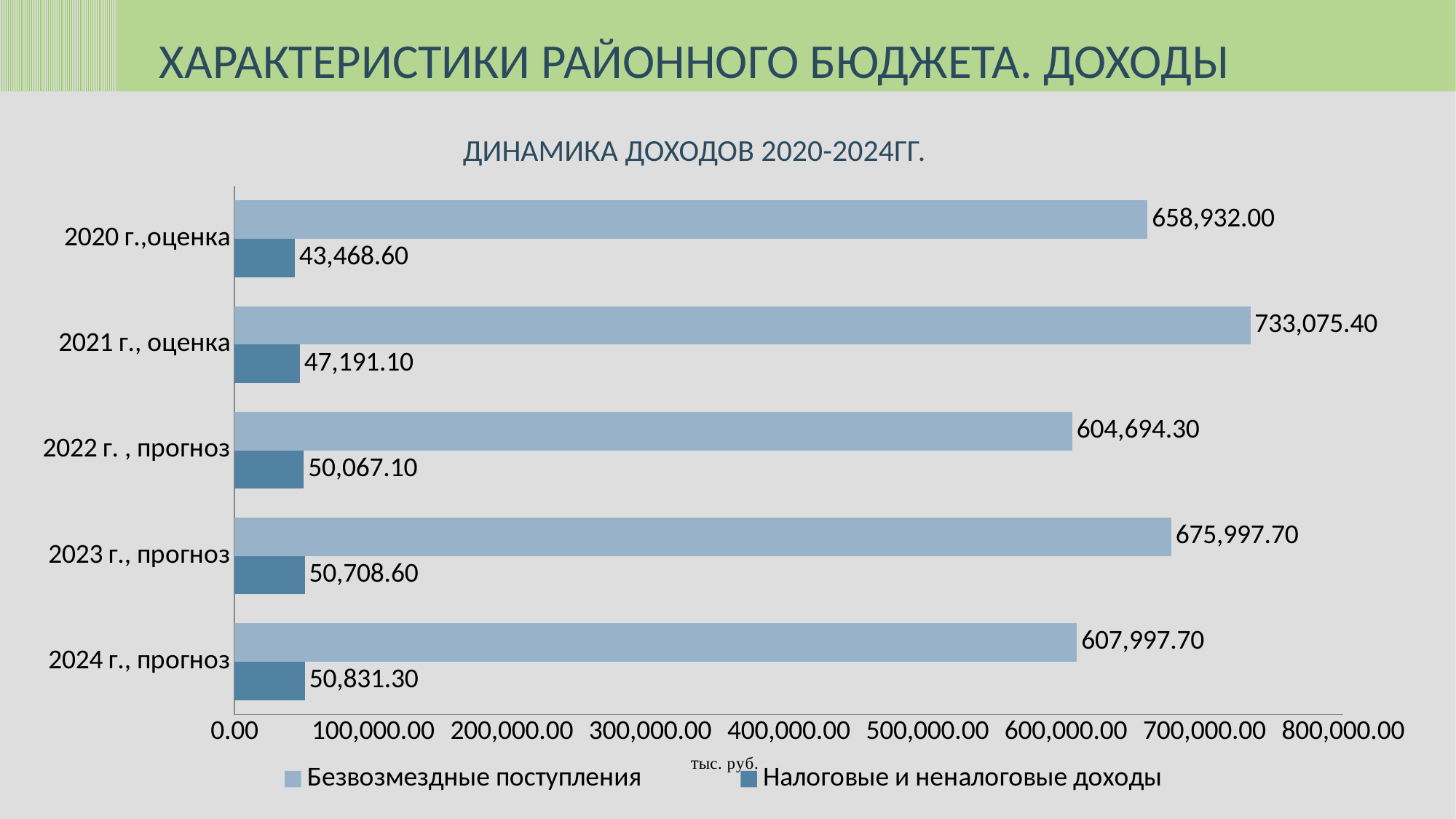
Which year has the lowest value of Налоговые и неналоговые доходы? 2020 г.,оценка What type of chart is shown on the slide? Bar chart Which year has the highest value of Безвозмездные поступления? 2021 г., оценка How many categories (years) are shown on the chart? 5 How many series does the legend list? 2 What is the title of the chart? ДИНАМИКА ДОХОДОВ 2020-2024ГГ. Is the value of Безвозмездные поступления for 2020 г.,оценка greater or less than 600,000.00? greater What is the difference between Безвозмездные поступления in 2021 г., оценка and 2020 г.,оценка? 74,143.40 What is the value of Безвозмездные поступления for 2021 г., оценка? 733,075.40 Which is larger: Безвозмездные поступления in 2023 г., прогноз or in 2024 г., прогноз? 2023 г., прогноз Do the values of Налоговые и неналоговые доходы rise or fall from 2020 to 2024? rise What is the value of Налоговые и неналоговые доходы for 2022 г., прогноз? 50,067.10